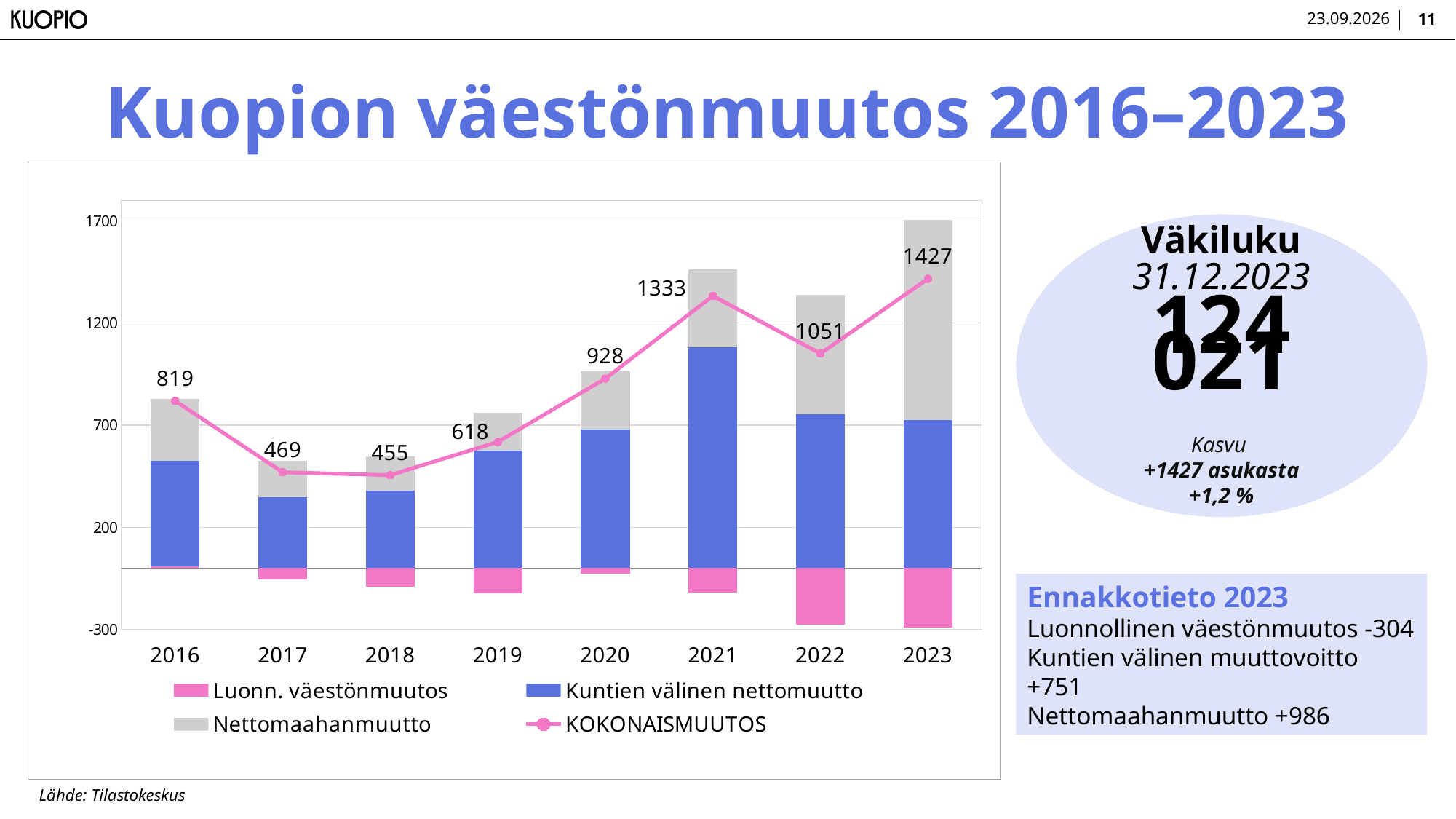
How many years are shown on the x axis of the chart? 8 Which year has the highest KOKONAISMUUTOS value? 2023 Is the Kuntien välinen nettomuutto value for 2021 greater or less than 700? greater Which year has the lowest KOKONAISMUUTOS value? 2018 What is the difference between the KOKONAISMUUTOS values for 2023 and 2022? 376 What is the KOKONAISMUUTOS value for 2021? 1333 What is the KOKONAISMUUTOS value for 2016? 819 Which colour represents Luonn. väestönmuutos in the chart? Pink What is the KOKONAISMUUTOS value for 2022? 1051 Which year has a larger KOKONAISMUUTOS value, 2019 or 2020? 2020 How many series does the chart legend list? 4 Does the KOKONAISMUUTOS line rise or fall from 2018 to 2021? rise